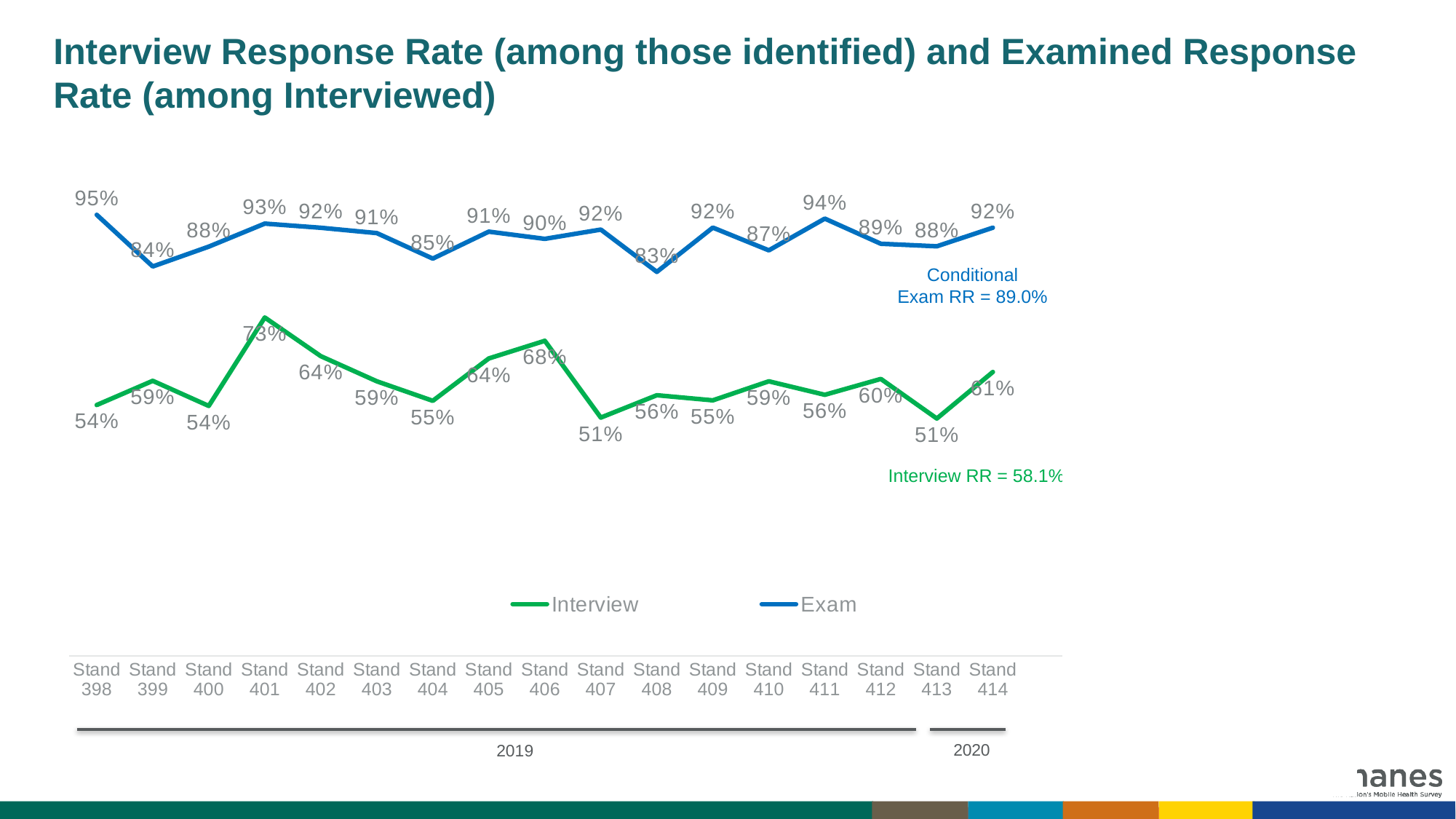
Which stand has the lowest Exam response rate? Stand 408 What is the Exam response rate for Stand 411? 94% What is the difference between the Exam and Interview response rates at Stand 398? 41 percentage points What is the Interview response rate for Stand 414? 61% Which is larger: the Interview response rate at Stand 401 or at Stand 406? Stand 401 How many stands are shown on the x axis? 17 Which stand has the highest Exam response rate? Stand 398 How many series does the legend list? 2 What is the Interview response rate for Stand 401? 73% Which stand has the highest Interview response rate? Stand 401 What is the Exam response rate for Stand 398? 95% What kind of chart is shown on the slide? Line chart